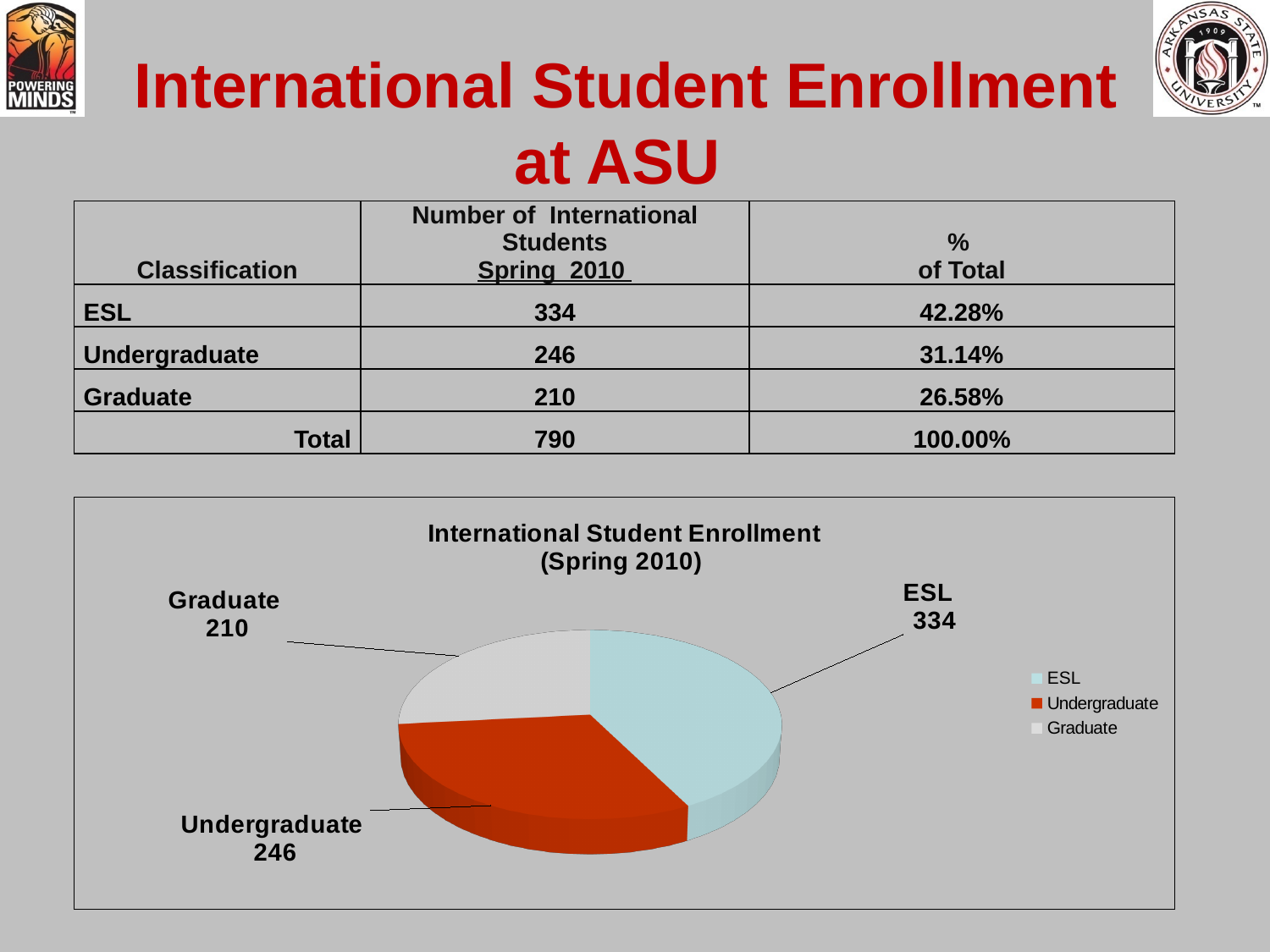
What is the value for Graduate in the pie chart? 210 Which category has the largest slice of the pie? ESL How many entries does the legend list? 3 What type of chart is shown on the slide? pie chart What is the difference between the Undergraduate and Graduate values? 36 How many slices does the pie chart have? 3 What is the title of the chart? International Student Enrollment (Spring 2010) What is the value for ESL in the pie chart? 334 What is the difference between the ESL and Graduate values? 124 Which category has the smallest slice of the pie? Graduate Which is larger, the ESL slice or the Undergraduate slice? ESL What is the value for Undergraduate in the pie chart? 246